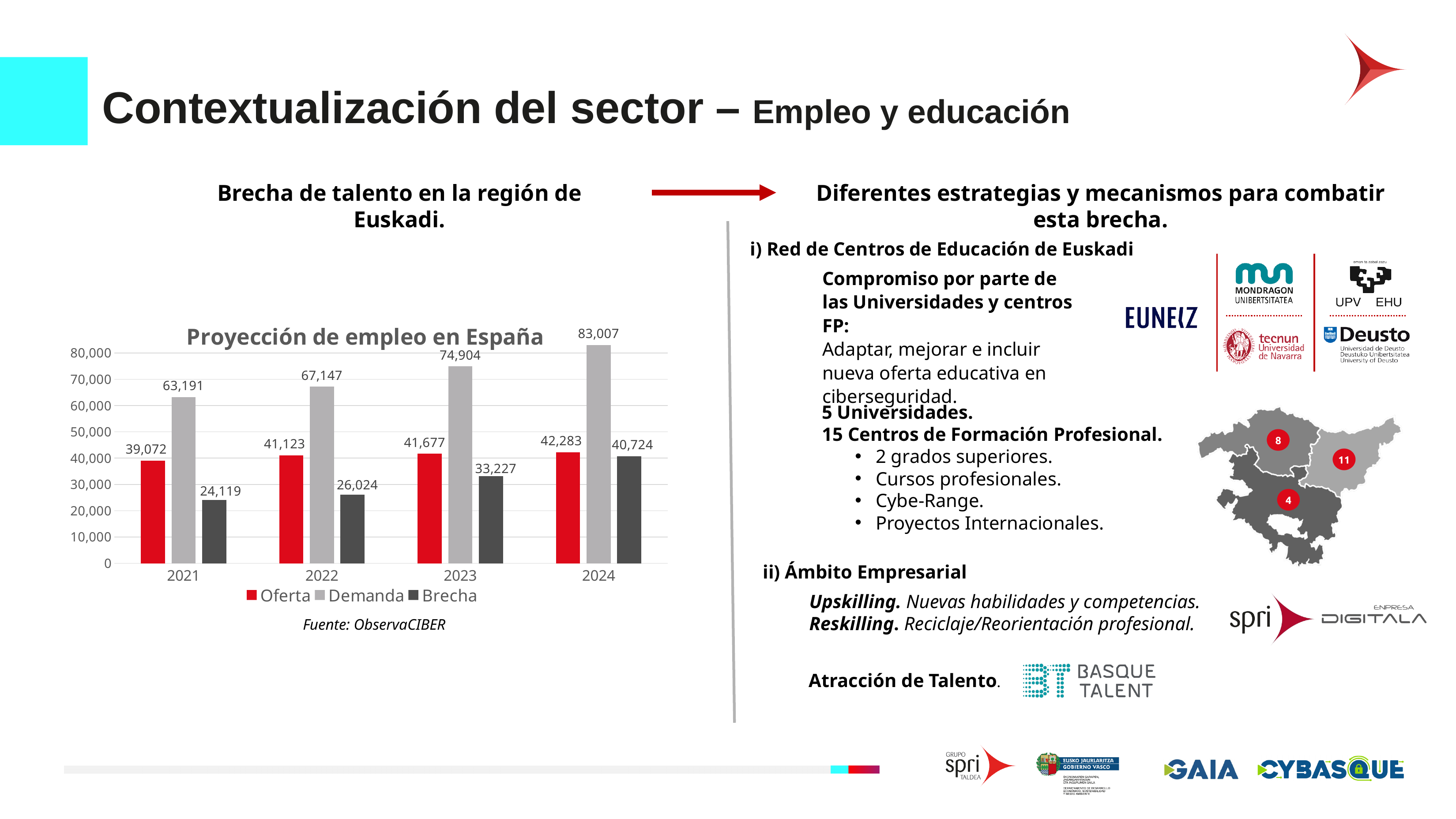
What is the Brecha value for 2024? 40,724 How many years are shown on the x axis of the chart? 4 In which year is the Demanda value highest? 2024 Which is larger in 2022: Oferta or Brecha? Oferta What is the Demanda value for 2023 in the 'Proyección de empleo en España' chart? 74,904 In which year is the Brecha value lowest? 2021 What is the difference between the Brecha values for 2024 and 2023? 7,497 What is the difference between the Demanda values for 2024 and 2021? 19,816 Is the Demanda value for 2024 greater or less than 80,000? greater How many series does the chart legend list? 3 Does the Brecha value rise or fall from 2021 to 2024? rise What is the Oferta value for 2021? 39,072